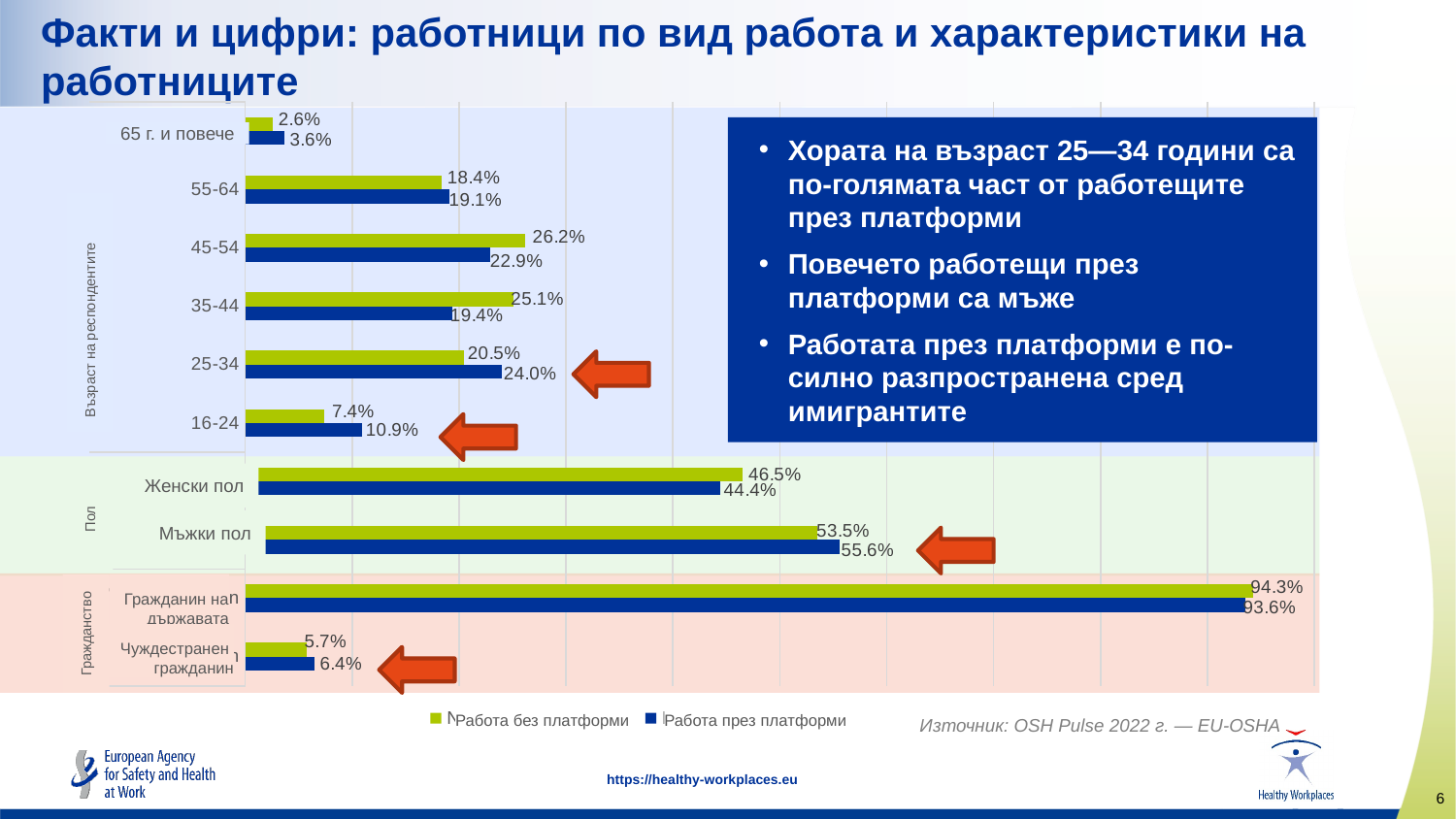
Among the age groups, which has the highest value for "Работа през платформи"? 25-34 Which colour represents "Работа през платформи" in the chart? Blue What is the value for "Работа през платформи" for "Мъжки пол"? 55.6% How many categories are shown on the chart? 10 How many series does the legend list? 2 What kind of chart is shown on the slide? Bar chart What is the difference between the "Работа през платформи" and "Работа без платформи" values for the 16-24 age group? 3.5% What is the value for "Работа без платформи" for "Чуждестранен гражданин"? 5.7% What is the value for "Работа през платформи" in the 25-34 age group? 24.0% For the 35-44 age group, which series has the larger value: "Работа без платформи" or "Работа през платформи"? Работа без платформи Among the age groups, which has the lowest value for "Работа без платформи"? 65 г. и повече What is the value for "Работа без платформи" in the 45-54 age group? 26.2%